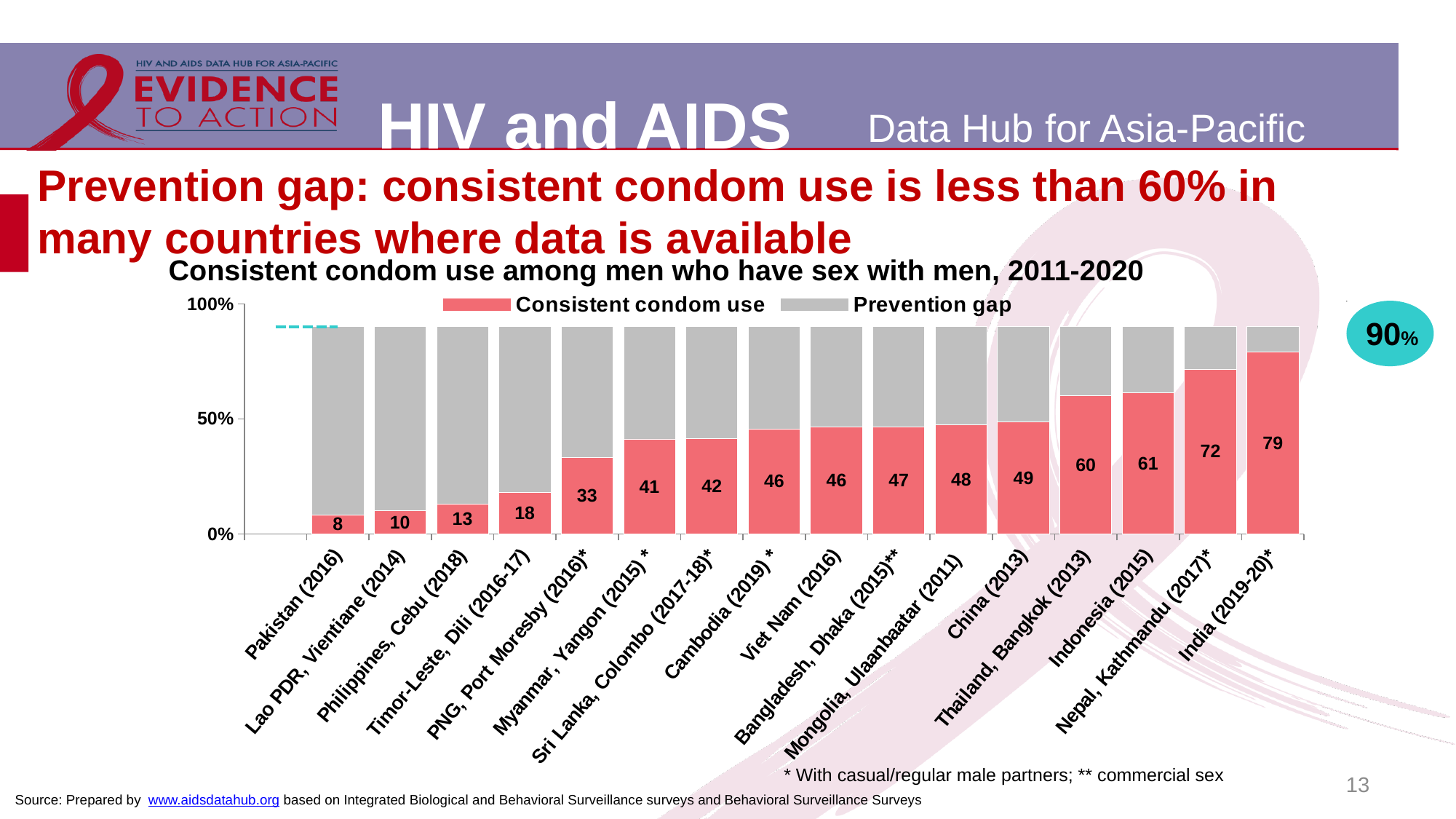
Which country has the lowest consistent condom use value? Pakistan (2016) Which country has the highest consistent condom use value? India (2019-20) Do the consistent condom use values rise or fall from left to right along the x axis? Rise What is the consistent condom use value for Nepal, Kathmandu (2017)? 72 What is the consistent condom use value for Pakistan (2016)? 8 How many series does the chart legend list? 2 What is the difference between the consistent condom use values for India (2019-20) and Pakistan (2016)? 71 What kind of chart is shown on the slide? Stacked bar chart Is the consistent condom use value for PNG, Port Moresby (2016) greater or less than 50%? less Which has a higher consistent condom use value, China (2013) or Indonesia (2015)? Indonesia (2015) How many countries/cities are shown on the x axis of the chart? 16 What is the consistent condom use value for Thailand, Bangkok (2013)? 60